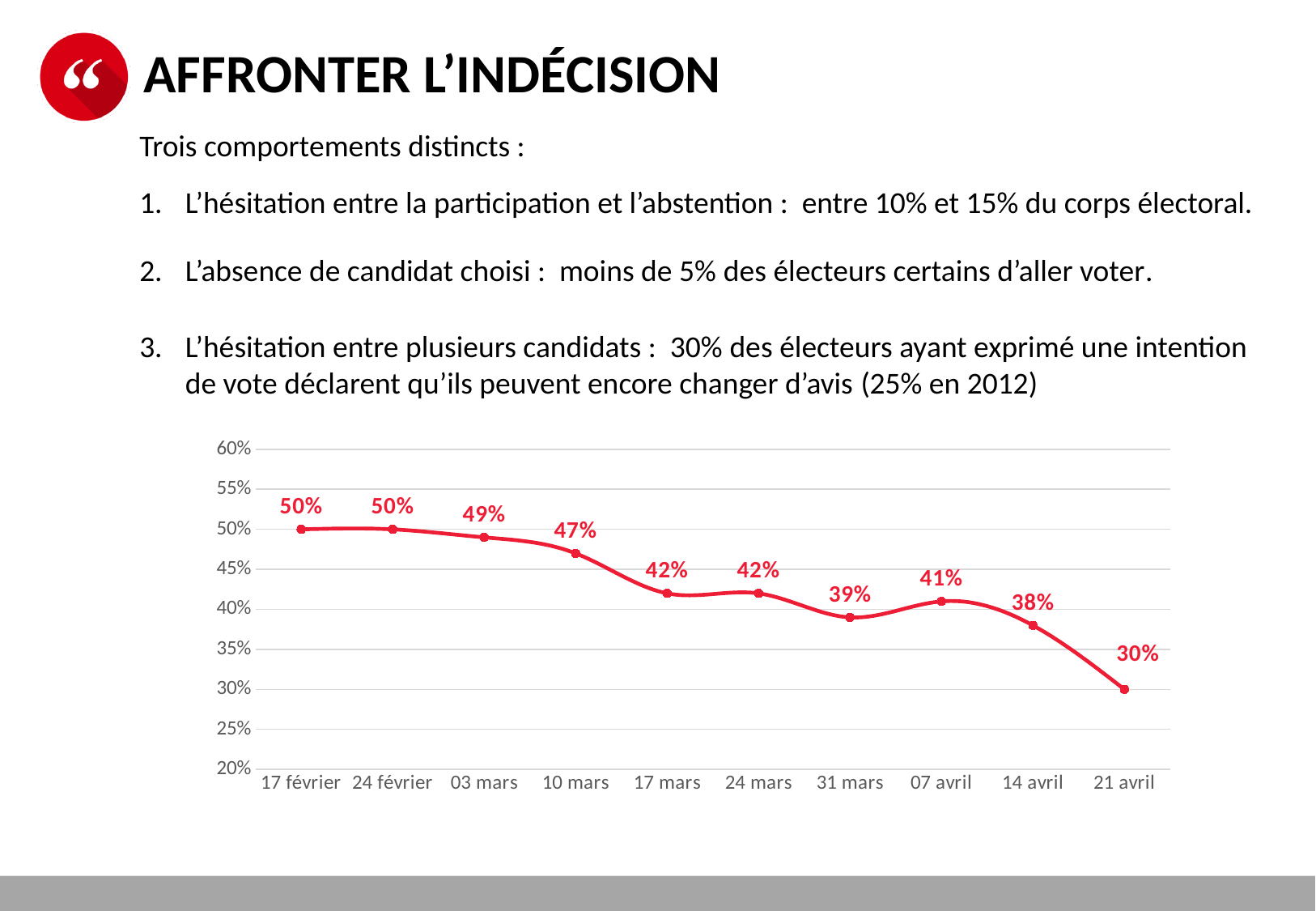
What kind of chart is shown on the slide? line chart What is the value for 21 avril? 30% Do the values generally rise or fall from 17 février to 21 avril? fall What is the difference between the values for 07 avril and 14 avril? 3% What is the value for 17 février? 50% Is the value for 14 avril greater or less than 40%? less What is the difference between the values for 17 février and 21 avril? 20% Which date has the lowest value? 21 avril How many data points are plotted on the chart? 10 Which is larger, the value for 03 mars or the value for 17 mars? 03 mars What is the value for 31 mars? 39% What is the value for 10 mars? 47%